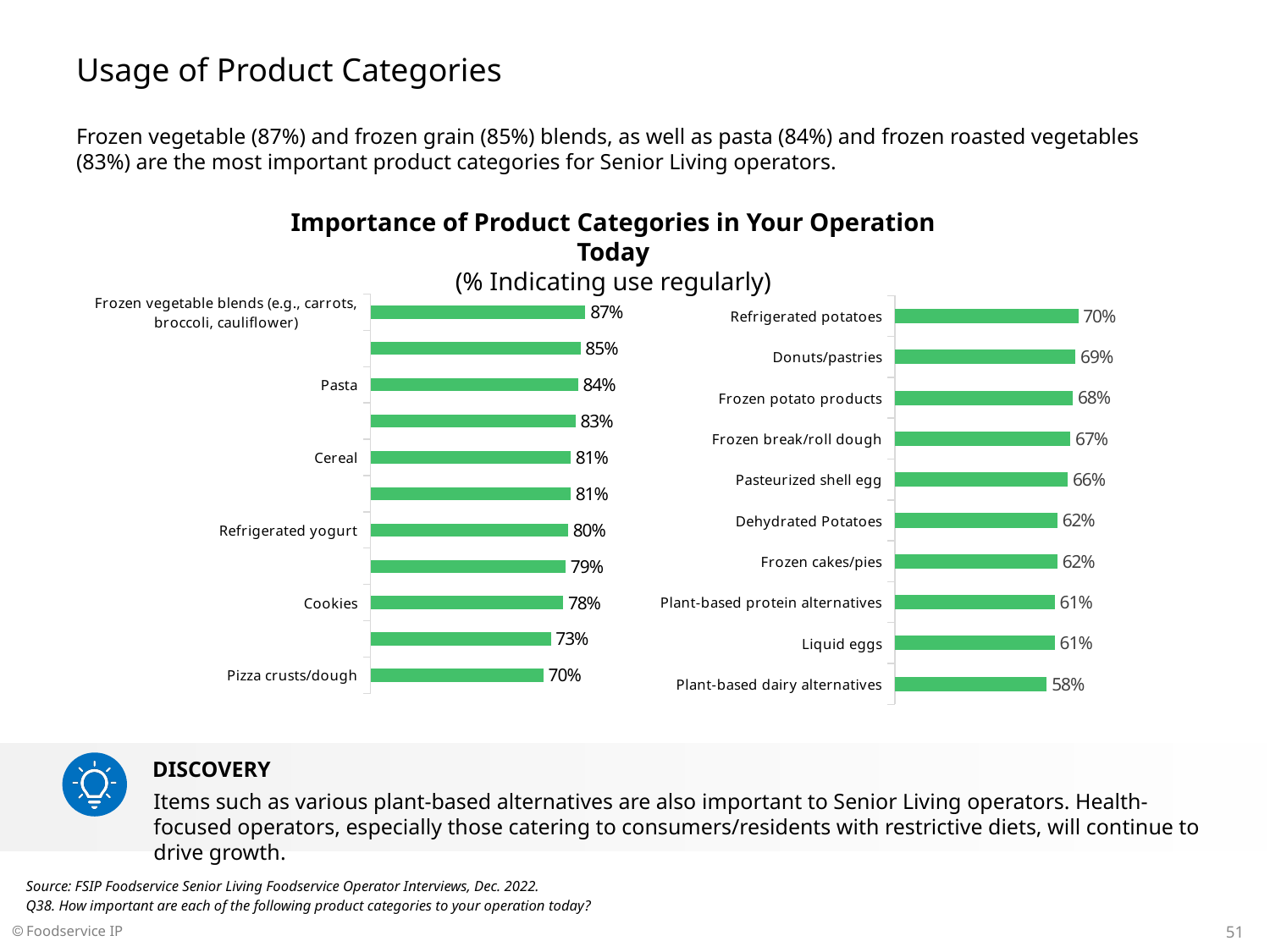
What kind of chart is the left chart? Bar chart In the right chart, which category has the highest value? Refrigerated potatoes In the left chart, which is larger, the value for Cookies or the value for Pizza crusts/dough? Cookies In the left chart, what is the value for Pasta? 84% In the right chart, what is the value for Frozen potato products? 68% In the left chart, what is the value for Refrigerated yogurt? 80% In the right chart, what is the difference between the values for Refrigerated potatoes and Liquid eggs? 9% How many bars are plotted in the right chart? 10 In the left chart, which category has the highest value? Frozen vegetable blends (e.g., carrots, broccoli, cauliflower) In the right chart, which category has the lowest value? Plant-based dairy alternatives In the right chart, what is the value for Plant-based dairy alternatives? 58% In the left chart, what is the difference between the values for Cereal and Pizza crusts/dough? 11%